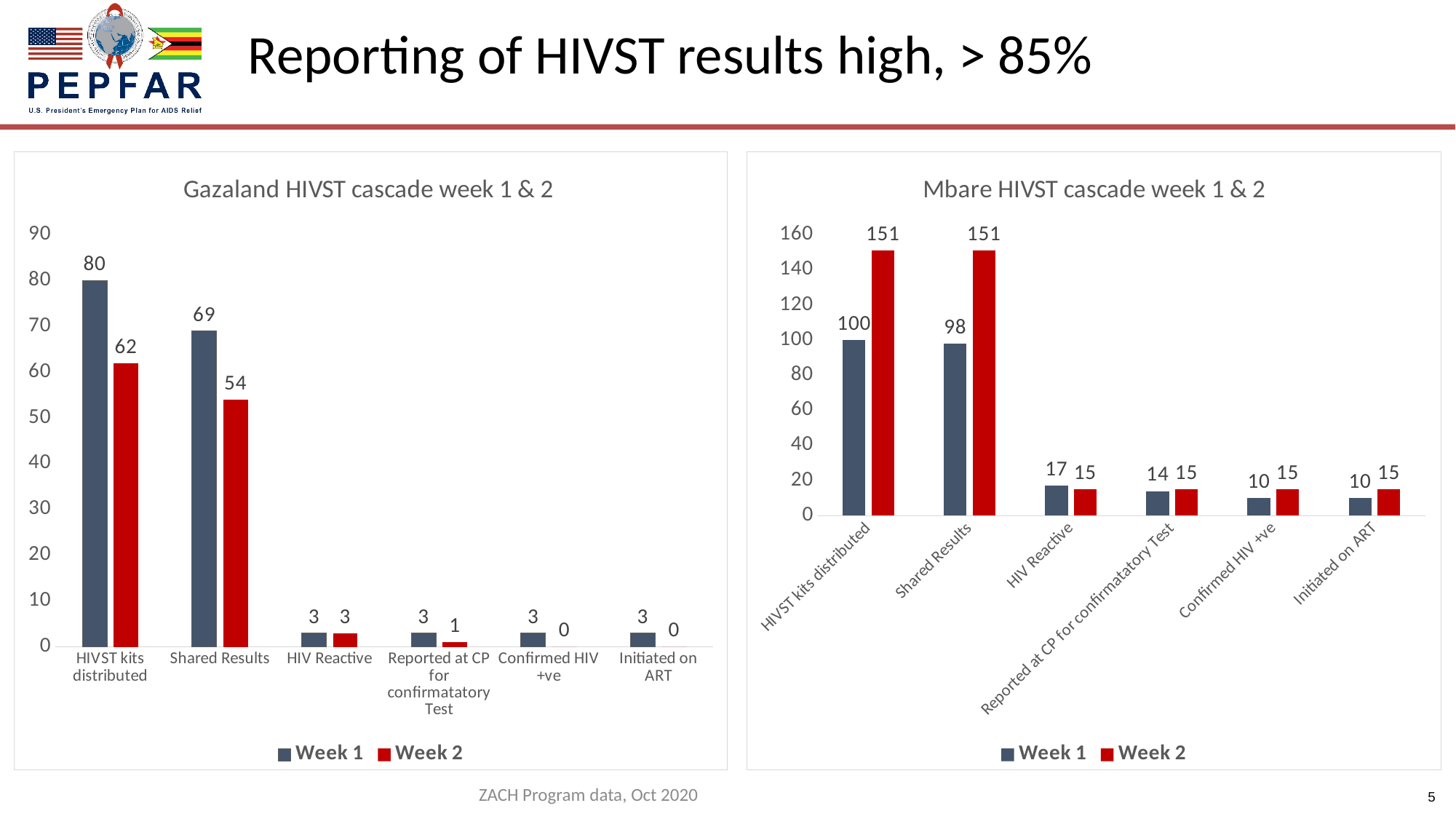
In the Mbare HIVST cascade week 1 & 2 chart, what is the Week 2 value for HIVST kits distributed? 151 How many series does the legend of the Mbare HIVST cascade week 1 & 2 chart list? 2 In the Gazaland HIVST cascade week 1 & 2 chart, what is the difference between the Week 1 and Week 2 values for HIVST kits distributed? 18 In the Gazaland HIVST cascade week 1 & 2 chart, which category has the highest Week 1 value? HIVST kits distributed In the Mbare HIVST cascade week 1 & 2 chart, which is larger for Shared Results: Week 1 or Week 2? Week 2 In the Gazaland HIVST cascade week 1 & 2 chart, what is the Week 2 value for Shared Results? 54 What kind of chart is the Gazaland HIVST cascade week 1 & 2 chart? Bar chart In the Mbare HIVST cascade week 1 & 2 chart, what is the Week 1 value for HIV Reactive? 17 How many categories are shown on the x axis of the Gazaland HIVST cascade week 1 & 2 chart? 6 In the Mbare HIVST cascade week 1 & 2 chart, which category has the lowest Week 1 value? Confirmed HIV +ve and Initiated on ART (both 10) In the Gazaland HIVST cascade week 1 & 2 chart, what is the Week 1 value for HIVST kits distributed? 80 In the Mbare HIVST cascade week 1 & 2 chart, what is the difference between the Week 2 and Week 1 values for Shared Results? 53